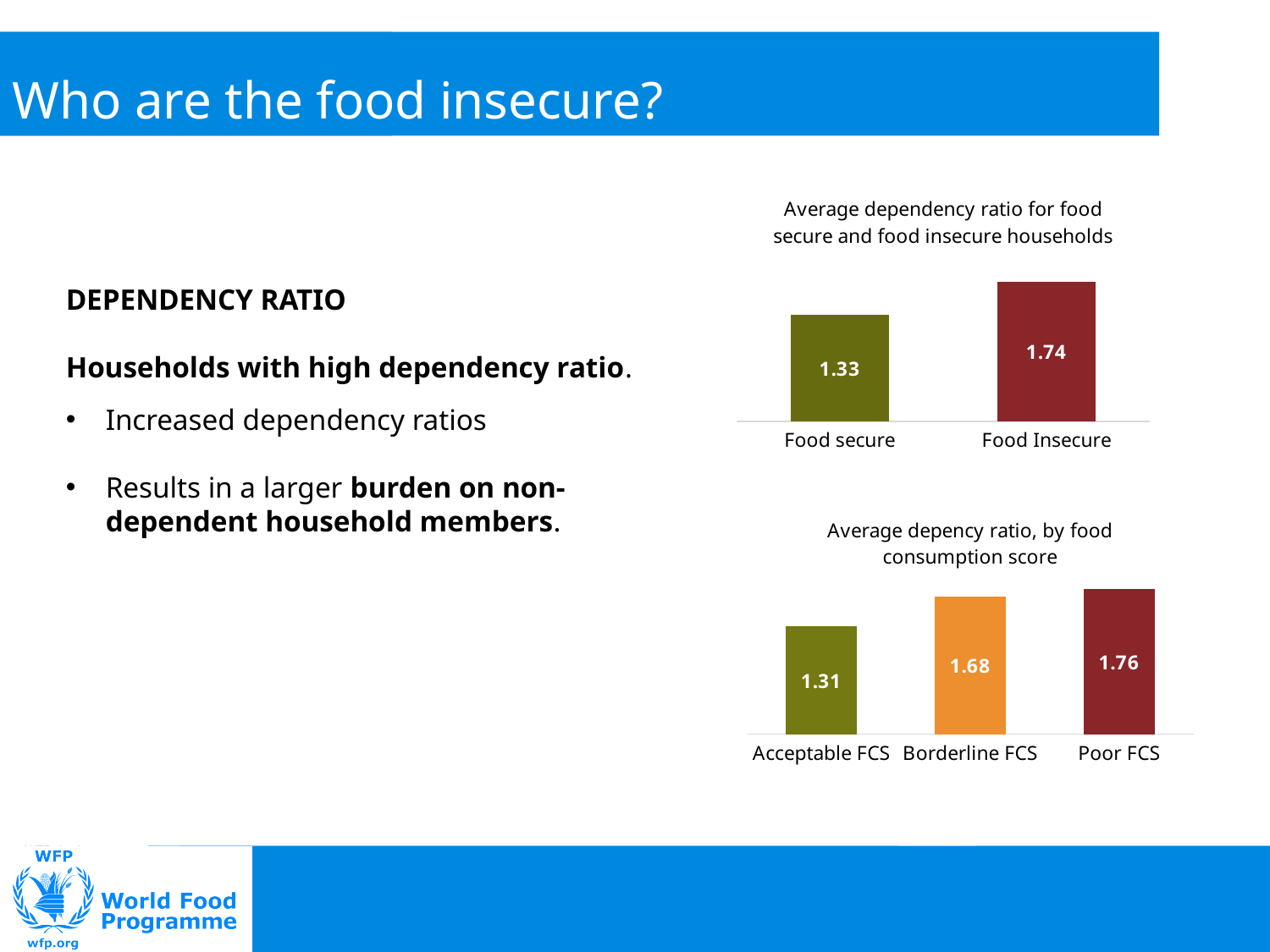
In the top chart (Average dependency ratio for food secure and food insecure households), what is the value for Food Insecure? 1.74 In the top chart (Average dependency ratio for food secure and food insecure households), how many categories are shown? 2 In the bottom chart (Average depency ratio, by food consumption score), what is the value for Poor FCS? 1.76 In the bottom chart (Average depency ratio, by food consumption score), how many categories are shown? 3 In the bottom chart (Average depency ratio, by food consumption score), what is the difference between the Poor FCS and Acceptable FCS values? 0.45 In the bottom chart (Average depency ratio, by food consumption score), do the values rise or fall from Acceptable FCS to Poor FCS? rise What type of chart is the bottom chart (Average depency ratio, by food consumption score)? bar chart In the top chart (Average dependency ratio for food secure and food insecure households), what is the value for Food secure? 1.33 In the top chart (Average dependency ratio for food secure and food insecure households), what is the difference between the Food Insecure and Food secure values? 0.41 In the top chart (Average dependency ratio for food secure and food insecure households), which category has the higher value? Food Insecure In the bottom chart (Average depency ratio, by food consumption score), which category has the lowest value? Acceptable FCS In the bottom chart (Average depency ratio, by food consumption score), what is the value for Borderline FCS? 1.68